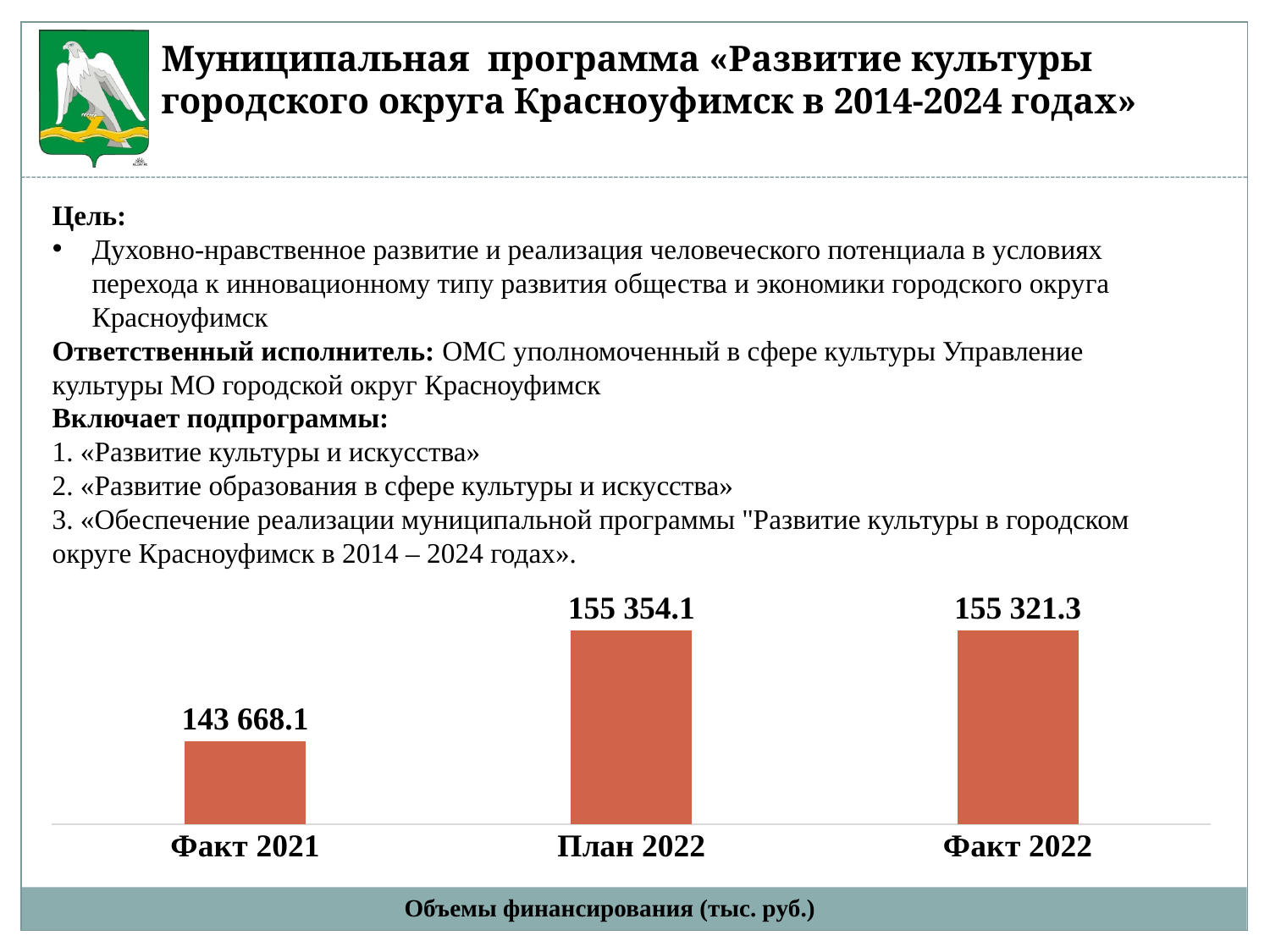
What is the value for Факт 2022 in the chart? 155 321.3 What is the title of the chart? Объемы финансирования (тыс. руб.) Which category has the highest value in the chart? План 2022 What kind of chart is shown on the slide? Bar chart What is the value for Факт 2021 in the chart? 143 668.1 What is the difference between the values for План 2022 and Факт 2021? 11 686.0 What is the difference between the values for План 2022 and Факт 2022? 32.8 Which category has the lowest value in the chart? Факт 2021 Which is larger, the value for Факт 2021 or the value for Факт 2022? Факт 2022 What is the value for План 2022 in the chart? 155 354.1 Does the value rise or fall from Факт 2021 to План 2022? Rises How many categories are shown in the chart? 3